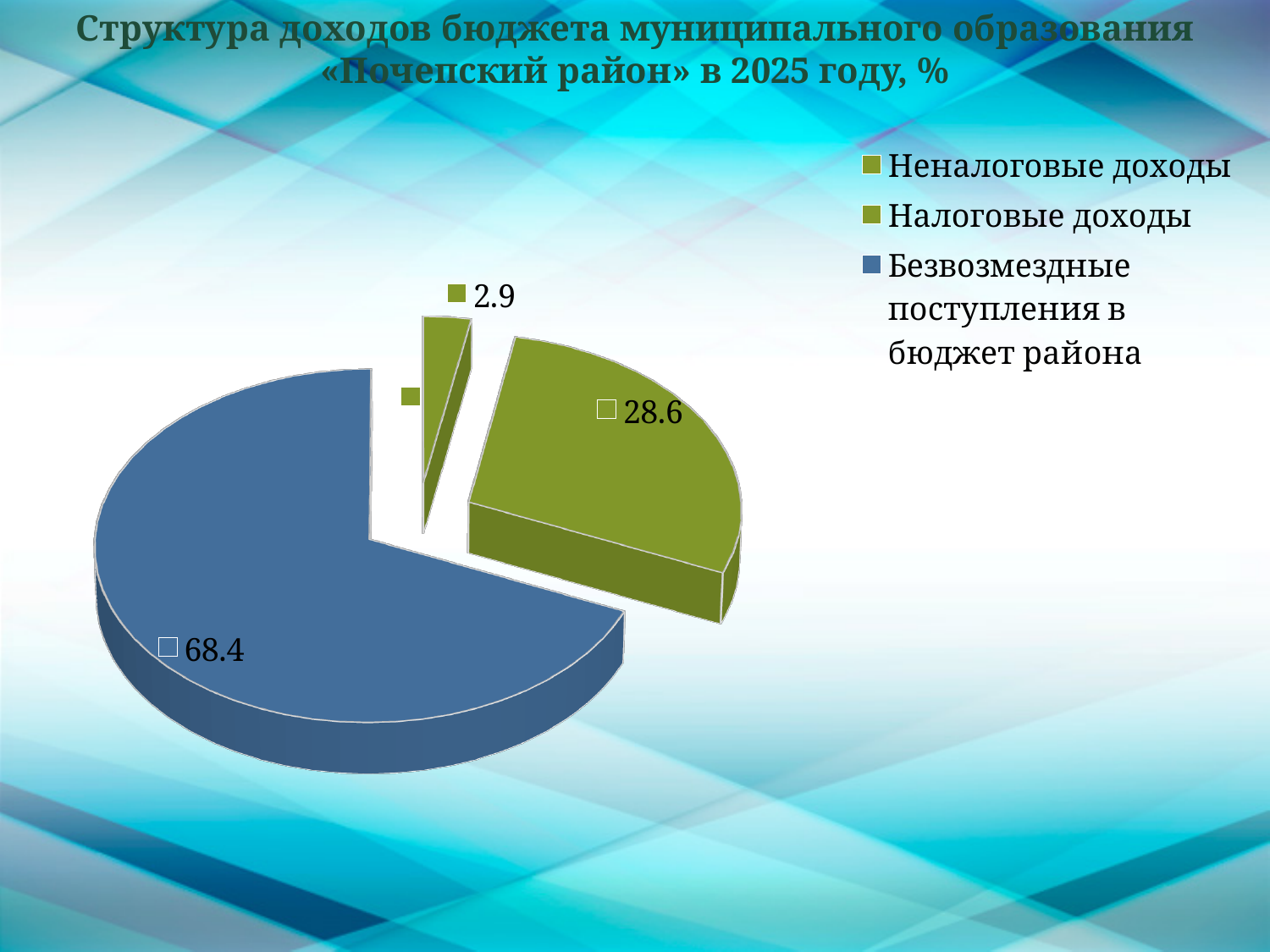
How many slices does the pie chart have? 3 What share of the pie is labelled for Безвозмездные поступления в бюджет района? 68.4 Which category has the largest slice of the pie? Безвозмездные поступления в бюджет района What kind of chart is shown on the slide? Pie chart How many entries does the legend list? 3 What is the difference between the values for Безвозмездные поступления в бюджет района and Налоговые доходы? 39.8 What is the difference between the values for Налоговые доходы and Неналоговые доходы? 25.7 Which category has the smallest slice of the pie? Неналоговые доходы What colour is the slice for Безвозмездные поступления в бюджет района? Blue What value is shown for Налоговые доходы? 28.6 What value is shown for Неналоговые доходы? 2.9 Which is larger, the slice for Налоговые доходы or the slice for Неналоговые доходы? Налоговые доходы